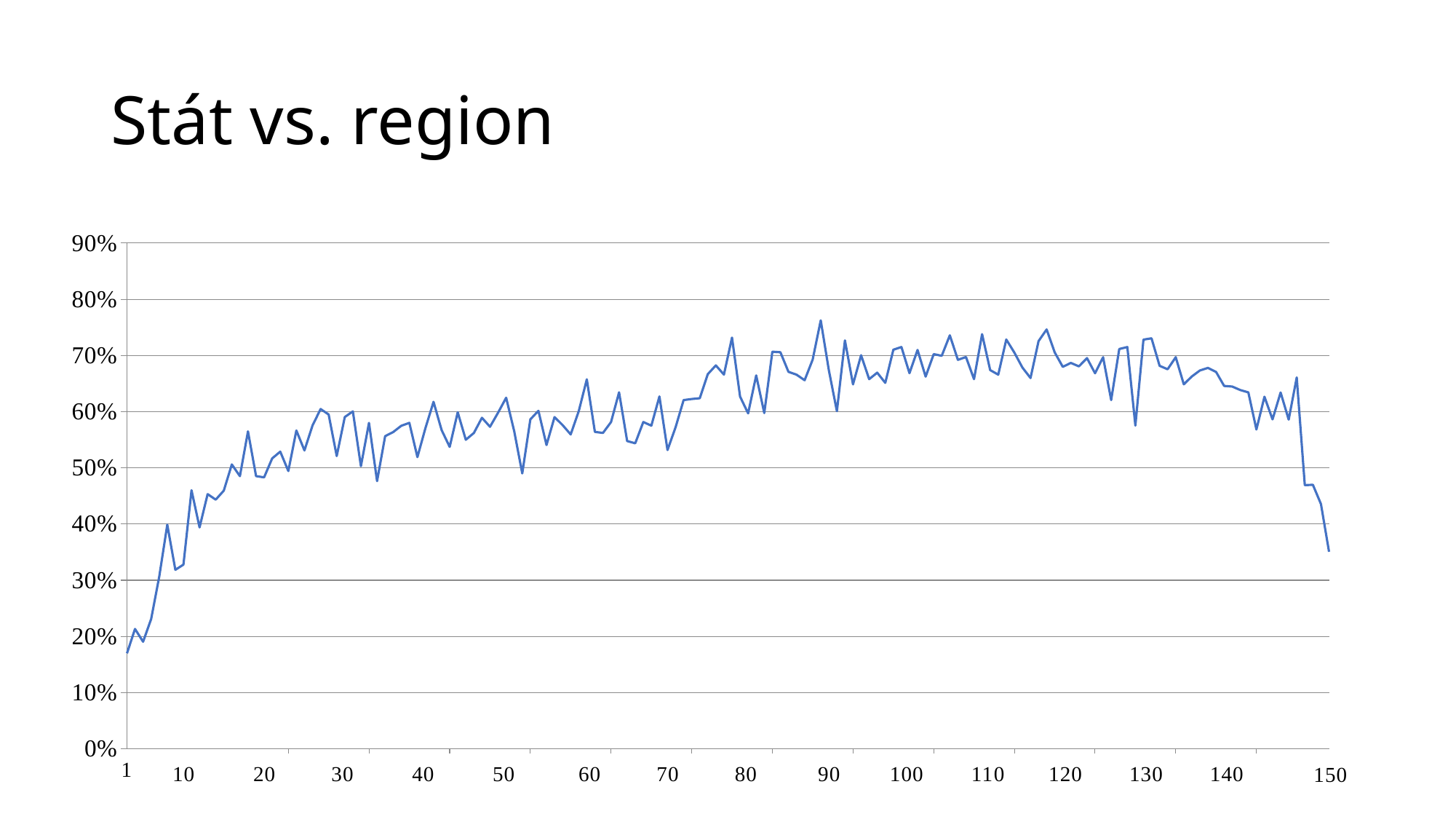
Is the highest point on the line greater or less than 70%? greater How many lines are plotted on the chart? 1 Do the values rise or fall between x = 140 and x = 150? fall Is the value at x = 150 greater or less than 40%? less What kind of chart is shown on the slide? line chart What is the title of the slide containing the chart? Stát vs. region Is the value at x = 10 greater or less than 30%? greater Do the values rise or fall between x = 1 and x = 10? rise At which x value does the line reach its lowest point? 1 How many data points does the x axis span, from its first to its last label? 150